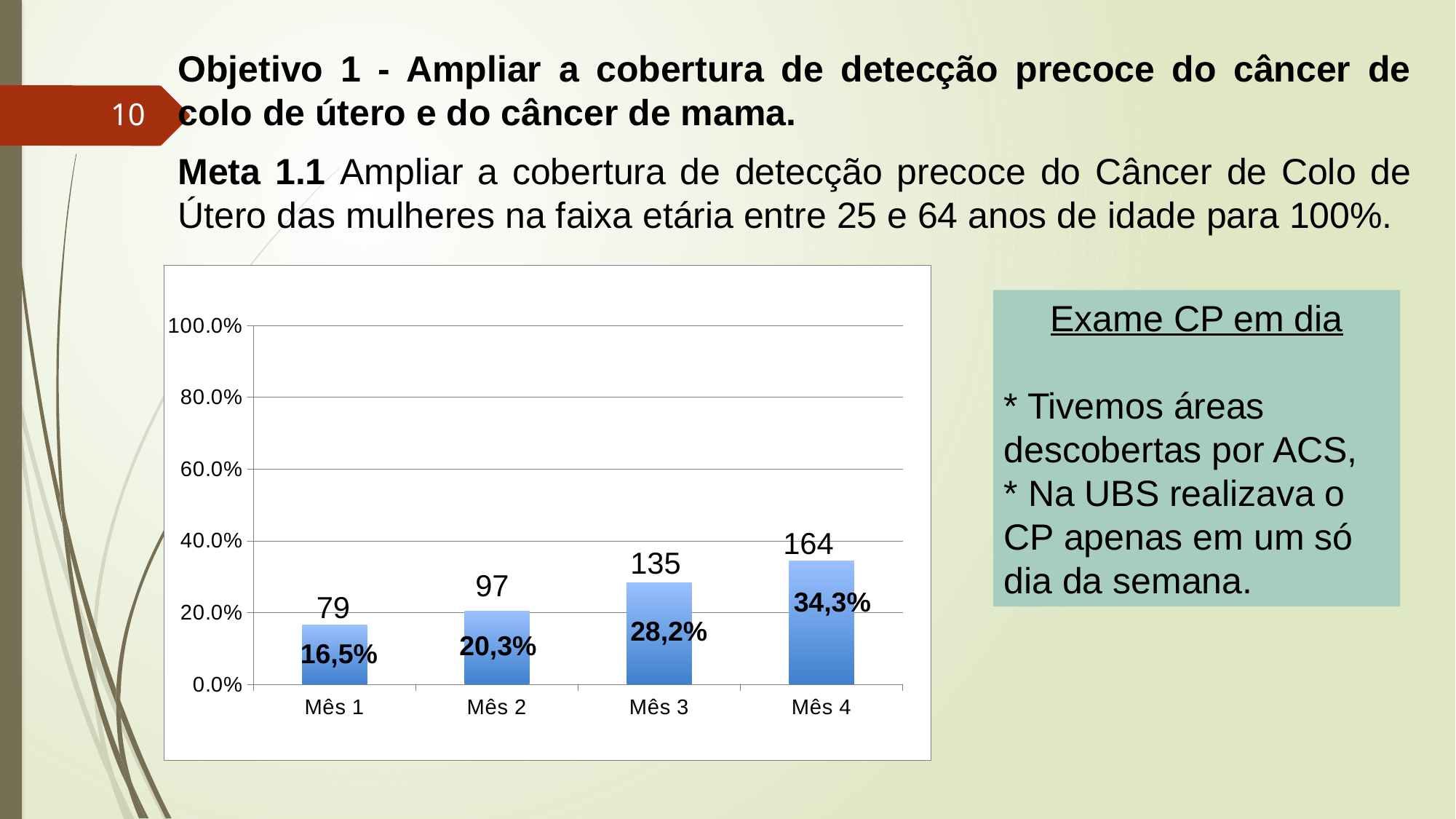
How many months are shown on the x axis? 4 Which month has the lowest bar? Mês 1 What count is labelled above the bar for Mês 4? 164 What kind of chart is this? bar chart Is the value for Mês 4 greater or less than 40.0%? less Do the values rise or fall from Mês 1 to Mês 4? rise What percentage is shown for Mês 1? 16,5% What is the difference between the counts for Mês 4 and Mês 3? 29 What percentage is shown for Mês 3? 28,2% Which is larger, the value for Mês 2 or Mês 3? Mês 3 What count is labelled above the bar for Mês 2? 97 Which month has the highest bar? Mês 4